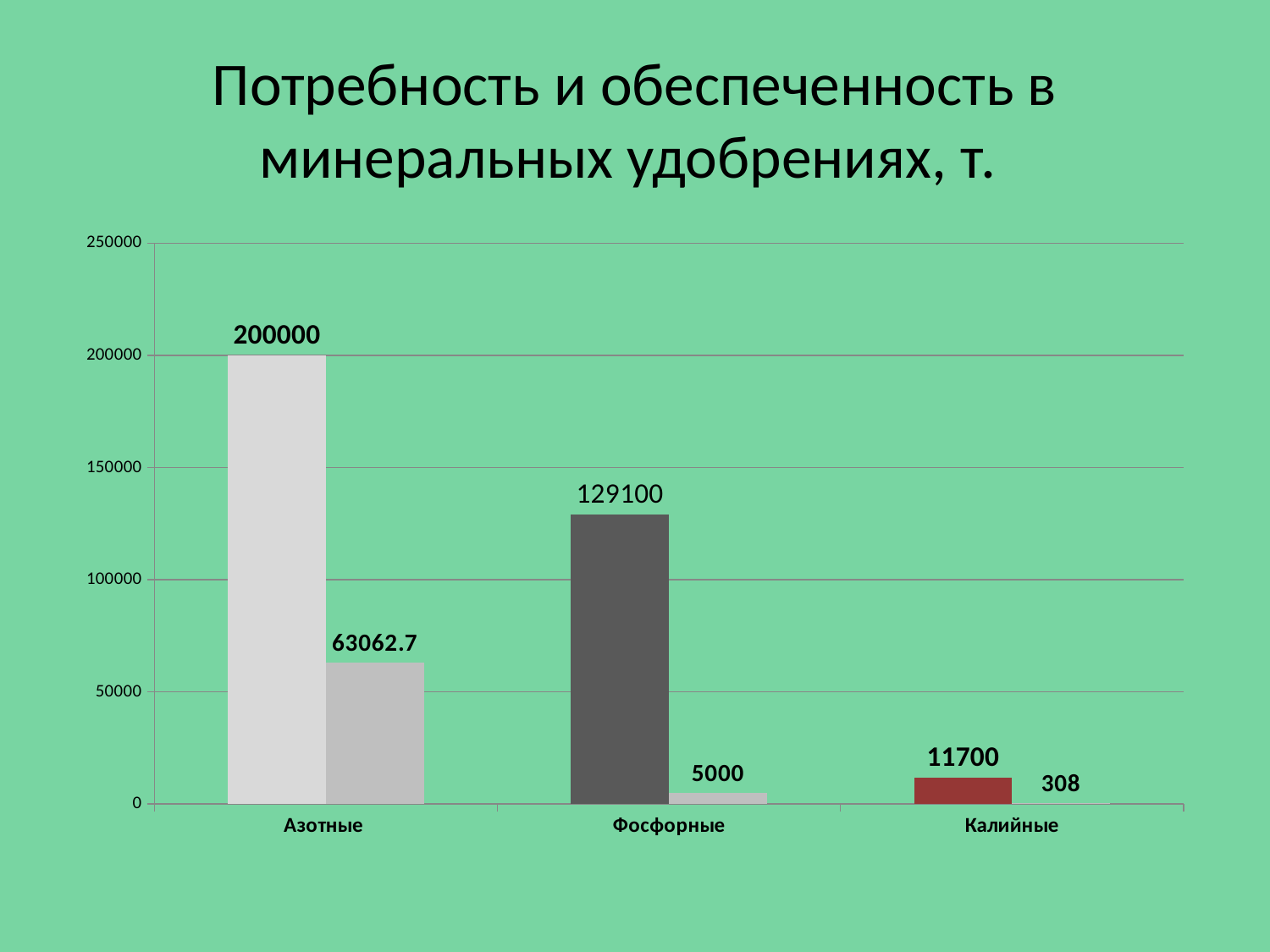
Which category has the lowest value among the right (second) bars? Калийные Which category has the highest value among the left (first) bars? Азотные What is the title of the chart on the slide? Потребность и обеспеченность в минеральных удобрениях, т. How many categories are shown on the x axis? 3 What is the value of the right (second) bar for Калийные? 308 What kind of chart is shown on the slide? bar chart What is the value of the left (first) bar for Азотные? 200000 What is the value of the left (first) bar for Фосфорные? 129100 What is the value of the right (second) bar for Азотные? 63062.7 Which is larger: the left bar for Фосфорные or the right bar for Азотные? the left bar for Фосфорные (129100) What is the difference between the two bars for Калийные (11700 and 308)? 11392 What is the difference between the two bars for Фосфорные (129100 and 5000)? 124100